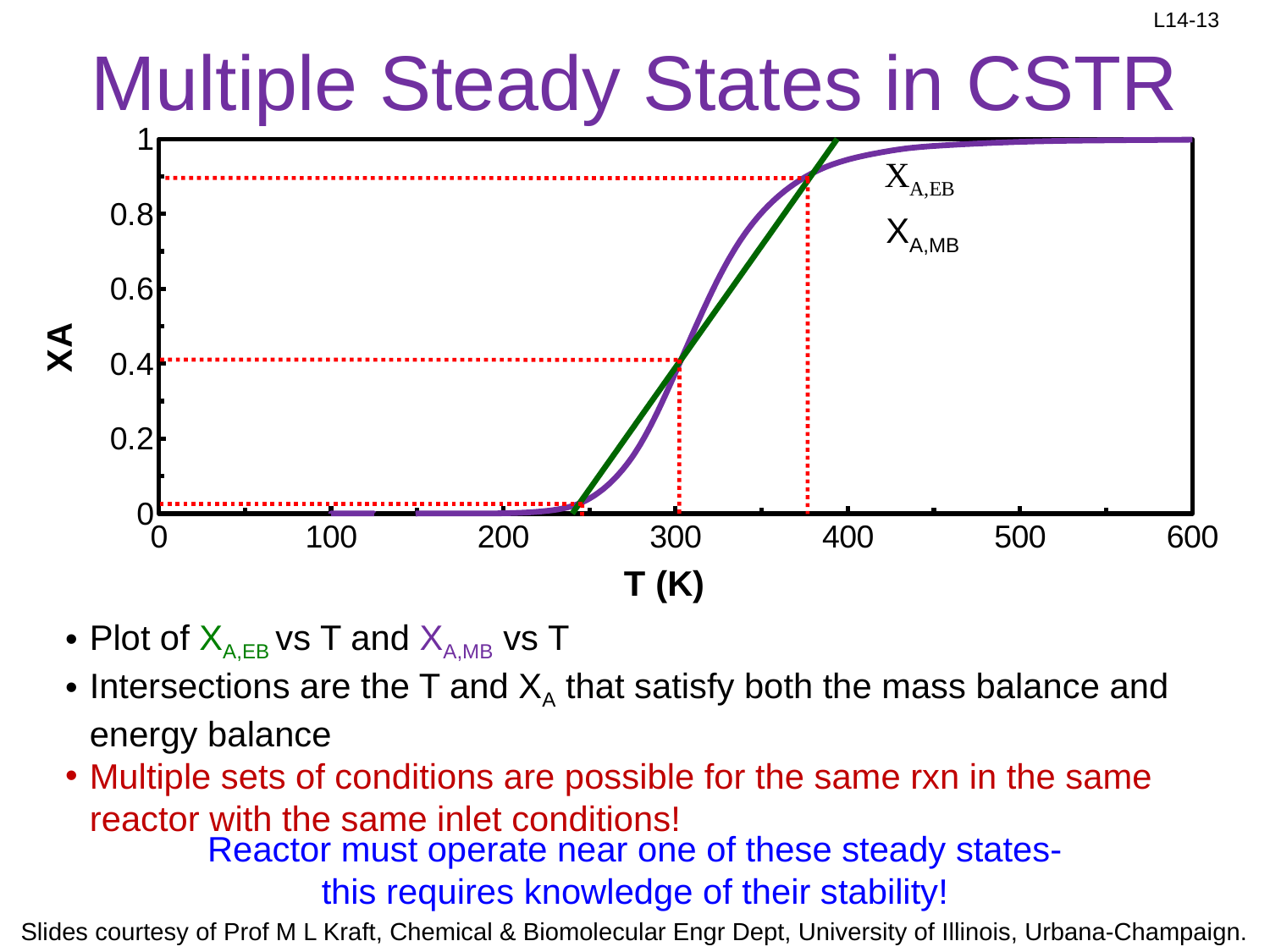
At T = 350 K, which series has the higher value, X_A,EB or X_A,MB? X_A,MB What is the title of the chart on the slide? Multiple Steady States in CSTR What is the highest value shown on the XA axis? 1 What is the label of the x axis? T (K) What kind of chart is shown on the slide? line chart Is the value of X_A,MB at T = 100 K greater or less than 0.2? less Is the value of X_A,MB at T = 300 K greater or less than 0.2? greater Is the value of X_A,MB at T = 500 K greater or less than 0.8? greater Does X_A,MB rise or fall as T increases? rise How many intersections between the two curves are marked with red dotted lines? 3 How many series are plotted on the chart? 2